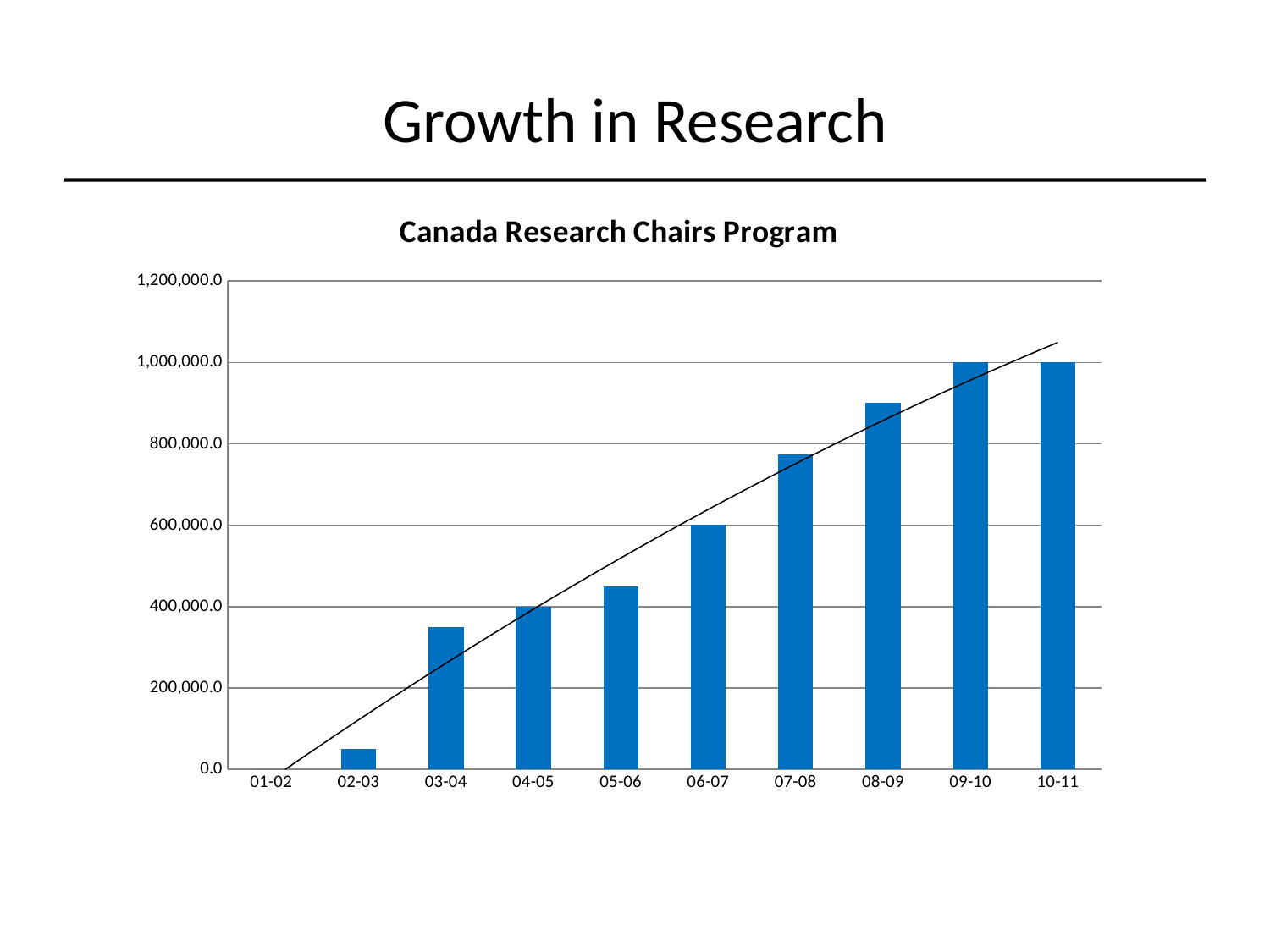
What is the value for 04-05? 400,000.0 Do the values generally rise or fall from 01-02 to 10-11? Rise Is the value for 05-06 greater or less than 600,000? less How many academic years are shown on the x axis of the chart? 10 What is the value for 09-10? 1,000,000.0 Is the value for 02-03 greater or less than 200,000? less What is the title of the chart? Canada Research Chairs Program Is the value for 08-09 greater or less than 800,000? greater Which is larger, the value for 03-04 or the value for 07-08? 07-08 What type of chart is shown on the slide? Bar chart